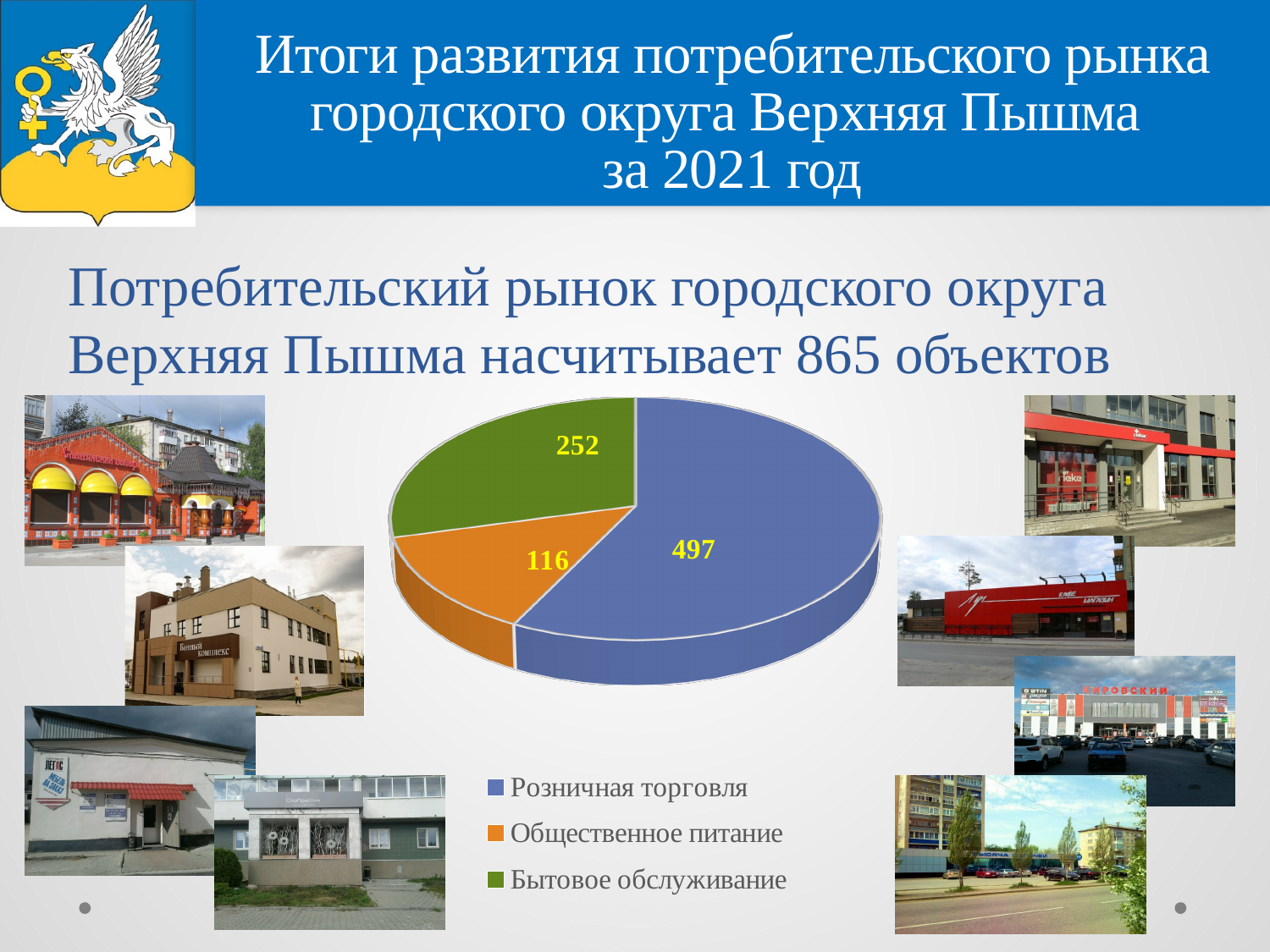
What is the value for Бытовое обслуживание in the pie chart? 252 Which colour represents Общественное питание in the pie chart? Orange What kind of chart is shown on the slide? Pie chart Which is larger, the value for Бытовое обслуживание or the value for Общественное питание? Бытовое обслуживание Which category has the largest slice in the pie chart? Розничная торговля How many entries does the legend of the pie chart list? 3 What is the value for Общественное питание in the pie chart? 116 Which category has the smallest slice in the pie chart? Общественное питание What is the difference between the values for Розничная торговля and Бытовое обслуживание? 245 How many slices does the pie chart have? 3 What is the value for Розничная торговля in the pie chart? 497 What is the total of all three slices in the pie chart? 865